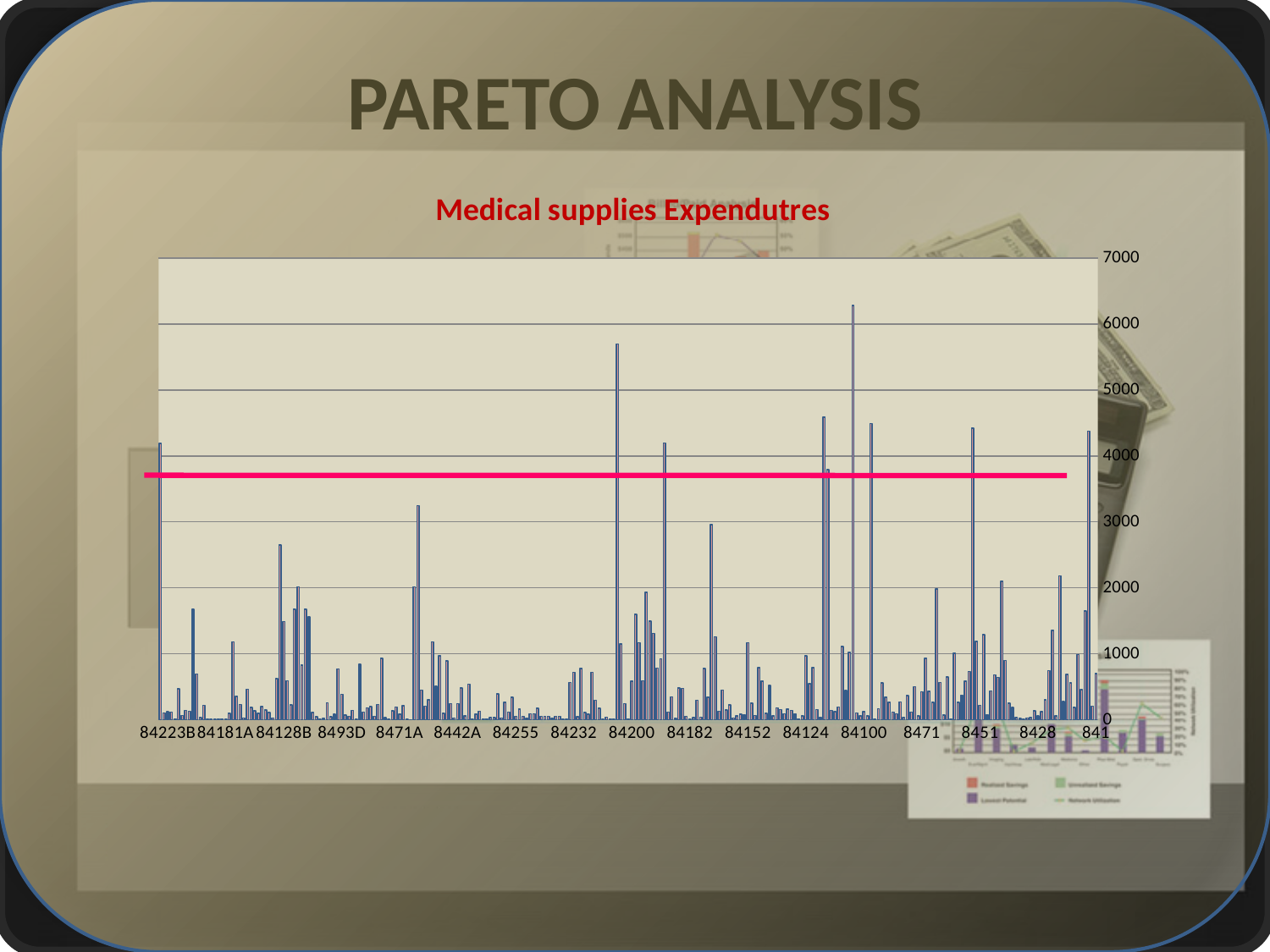
What is the title of the chart on the slide? Medical supplies Expendutres Is the tallest bar in the chart greater or less than 7000? less Is the tallest bar near the 84200 label greater or less than 5000? greater Is the tallest bar in the chart greater or less than 6000? greater How many category labels are printed along the x axis of the chart? 17 What kind of chart is shown under the title "Medical supplies Expendutres"? bar chart What is the highest value shown on the y axis of the chart? 7000